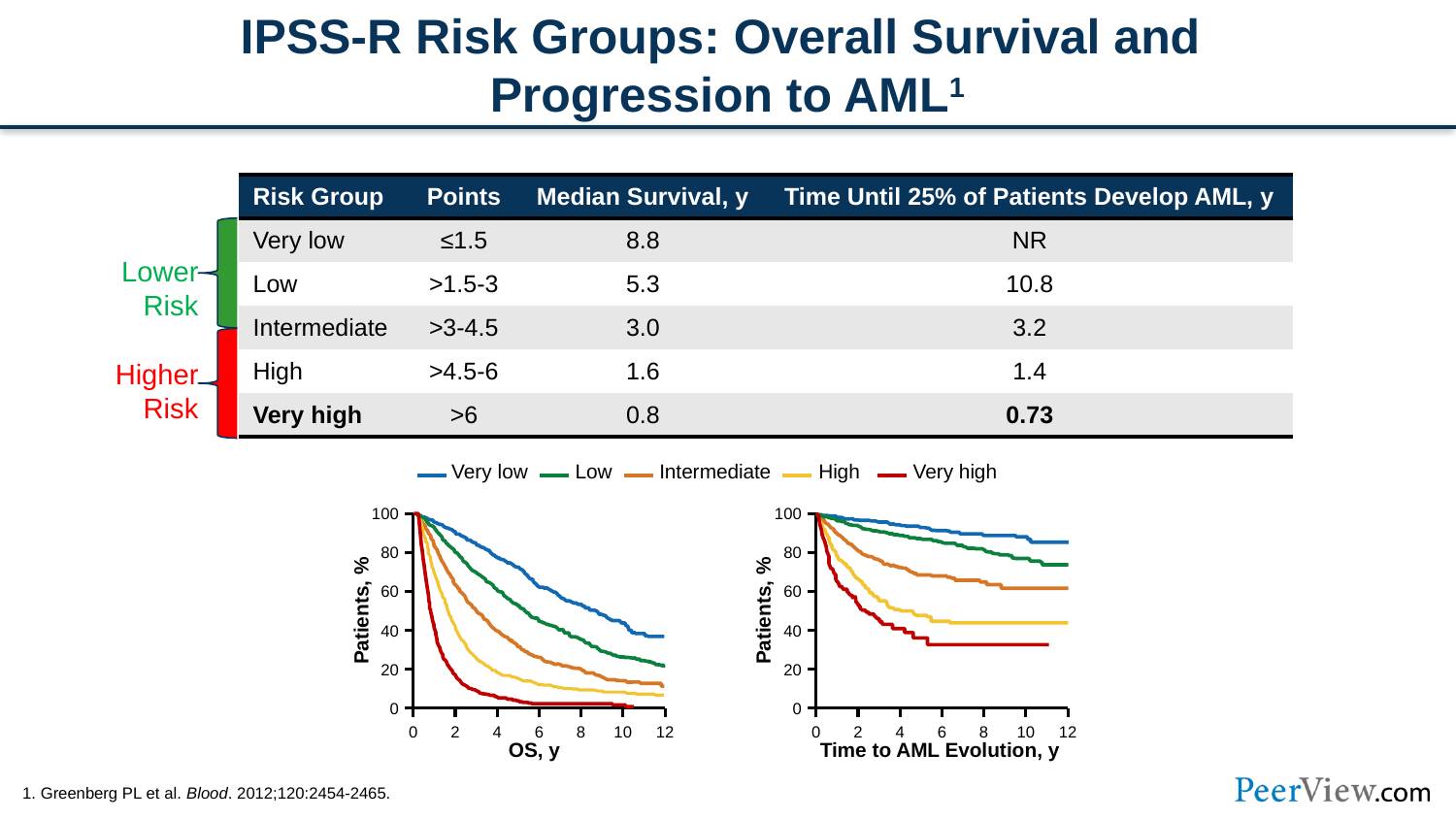
In the left chart (OS, y), at 6 years, which curve is higher: Very low or Very high? Very low How many charts are plotted on the slide? 2 In the left chart (OS, y), which series has the lowest curve at 6 years? Very high How many series does the shared legend above the two charts list? 5 In the right chart (Time to AML Evolution, y), is the Very low curve at 10 years greater or less than 80? greater In the right chart (Time to AML Evolution, y), is the Very high curve at 8 years greater or less than 40? less In the left chart (OS, y), is the Very high curve at 4 years greater or less than 20? less Which colour represents the Very high series in the legend? red In the right chart (Time to AML Evolution, y), which series has the highest curve at 10 years? Very low What is the x-axis title of the right chart? Time to AML Evolution, y In the left chart (OS, y), do the curves rise or fall as time increases along the x axis? fall What kind of chart is the left chart with the x axis labelled "OS, y"? line chart